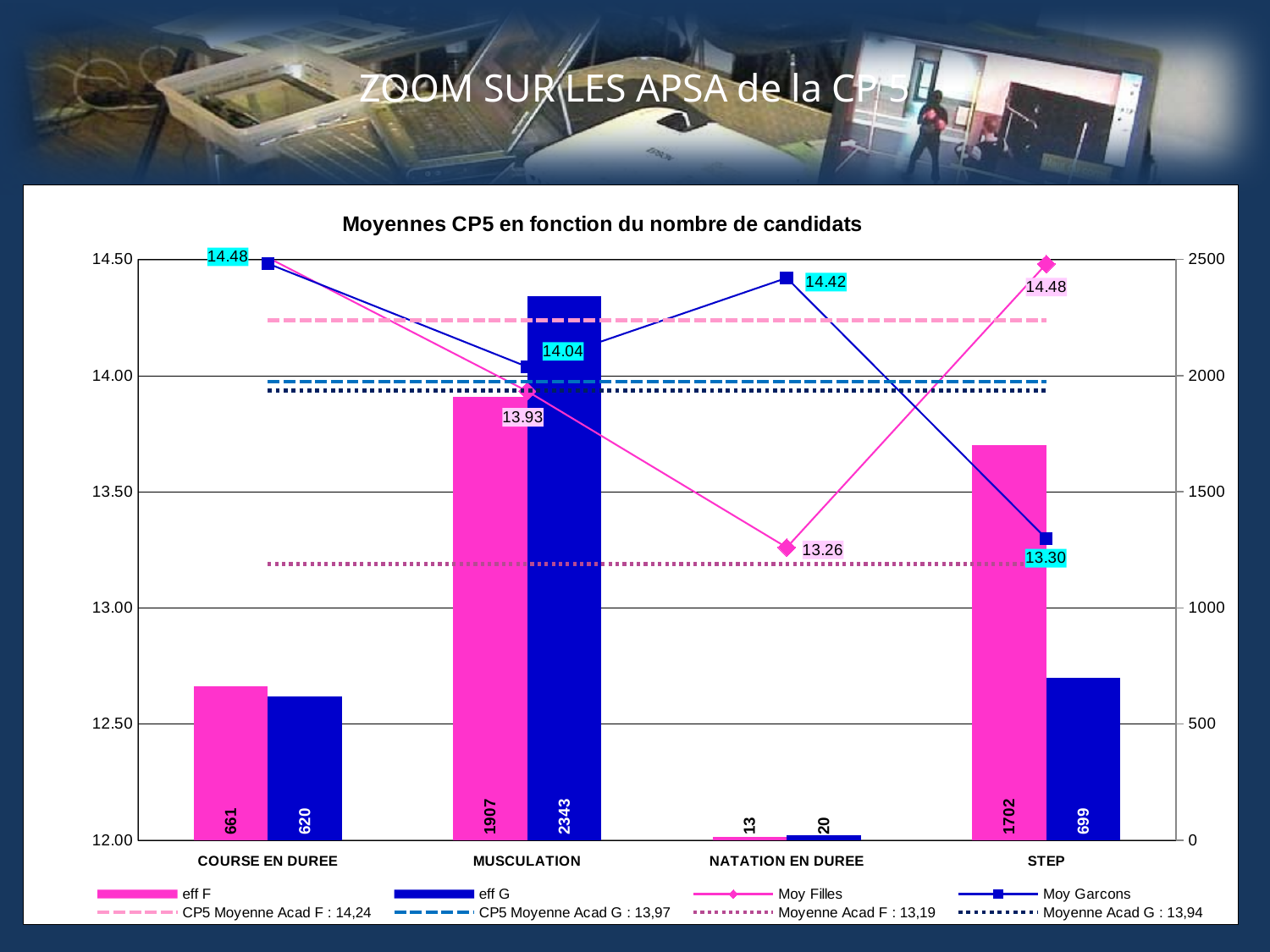
What is the value of eff G for MUSCULATION? 2343 What value does the legend give for CP5 Moyenne Acad F? 14,24 What is the Moy Garcons value for STEP? 13.30 What is the Moy Filles value for NATATION EN DUREE? 13.26 What is the value of eff F for STEP? 1702 How many categories are shown on the x axis? 4 What is the Moy Garcons value for NATATION EN DUREE? 14.42 For STEP, which is larger, eff F or eff G? eff F Which category has the highest eff F value? MUSCULATION What is the difference between eff G and eff F for MUSCULATION? 436 Which category has the lowest eff G value? NATATION EN DUREE How many series does the legend list? 8